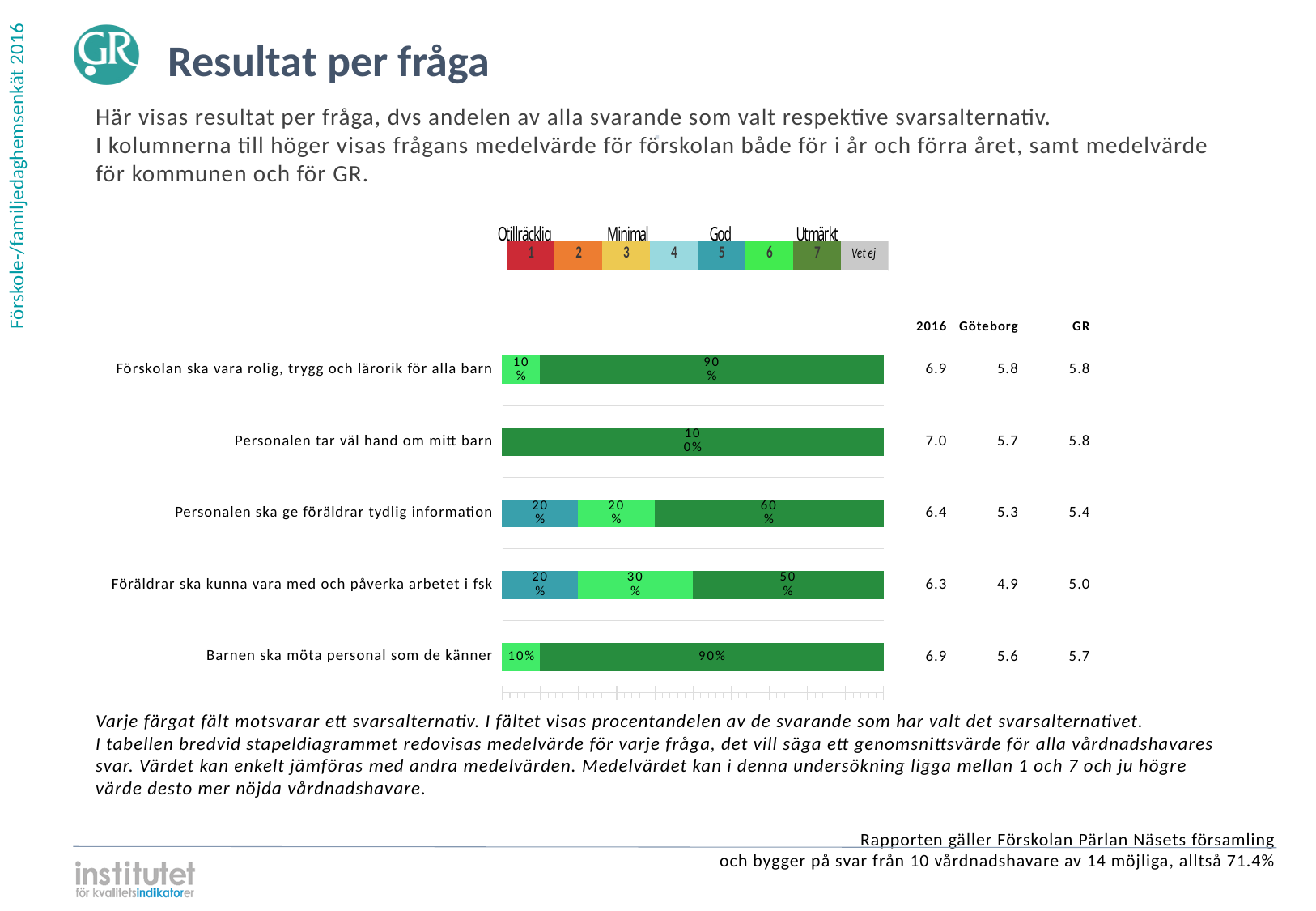
What is the total of the segments in the bar 'Personalen ska ge föräldrar tydlig information'? 100% What label is shown on the grey box at the right end of the colour legend? Vet ej How many questions (categories) are plotted as bars in the chart? 5 What kind of chart is shown on the slide? Stacked bar chart How many segments does the bar 'Föräldrar ska kunna vara med och påverka arbetet i fsk' have? 3 What percentage is shown for the dark green segment of the bar 'Personalen ska ge föräldrar tydlig information'? 60% Which question has the largest dark green segment? Personalen tar väl hand om mitt barn In the bar 'Personalen ska ge föräldrar tydlig information', how much larger is the dark green segment than the teal segment? 40 percentage points What percentage is shown for the dark green segment of the bar 'Förskolan ska vara rolig, trygg och lärorik för alla barn'? 90% What percentage is shown for the light green segment of the bar 'Föräldrar ska kunna vara med och påverka arbetet i fsk'? 30% What percentage is shown on the bar for 'Personalen tar väl hand om mitt barn'? 100% In the bar 'Föräldrar ska kunna vara med och påverka arbetet i fsk', which is larger: the teal segment or the dark green segment? The dark green segment (50%)